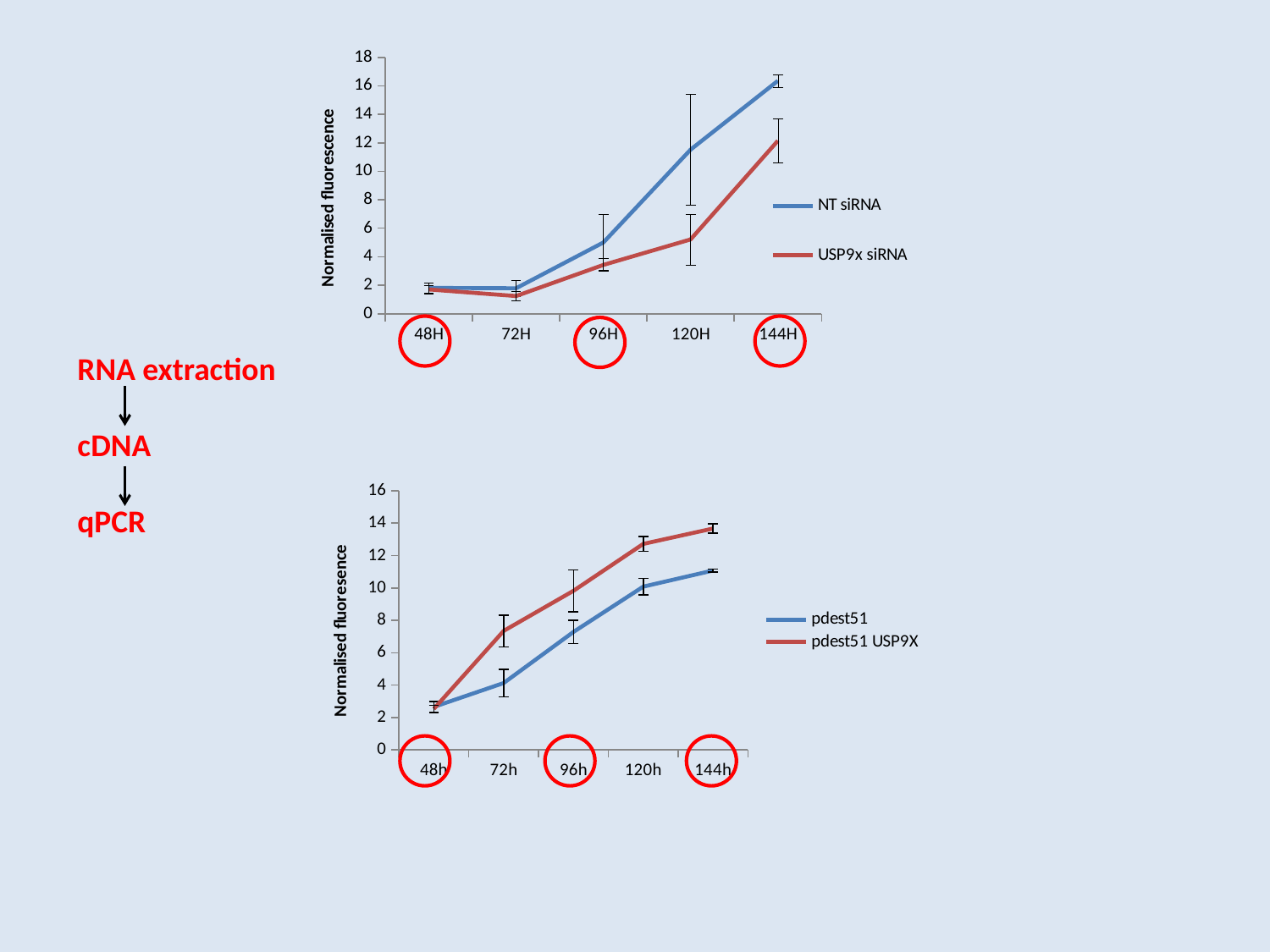
In the top chart, is the value for USP9x siRNA at 144H greater or less than 14? less How many series does the legend of the top chart list? 2 In the top chart, which series has the larger value at 120H, NT siRNA or USP9x siRNA? NT siRNA In the bottom chart, which colour is used for the pdest51 series? blue What is the y-axis label of the top chart? Normalised fluorescence How many time points are plotted along the x axis of the top chart? 5 In the top chart, do the NT siRNA values rise or fall from 72H to 144H? rise In the bottom chart, is the value for pdest51 USP9X at 144h greater or less than 12? greater In the top chart, is the value for NT siRNA at 144H greater or less than 14? greater What kind of chart is the top chart on the slide? line chart In the bottom chart, which series has the larger value at 72h, pdest51 or pdest51 USP9X? pdest51 USP9X How many series does the legend of the bottom chart list? 2